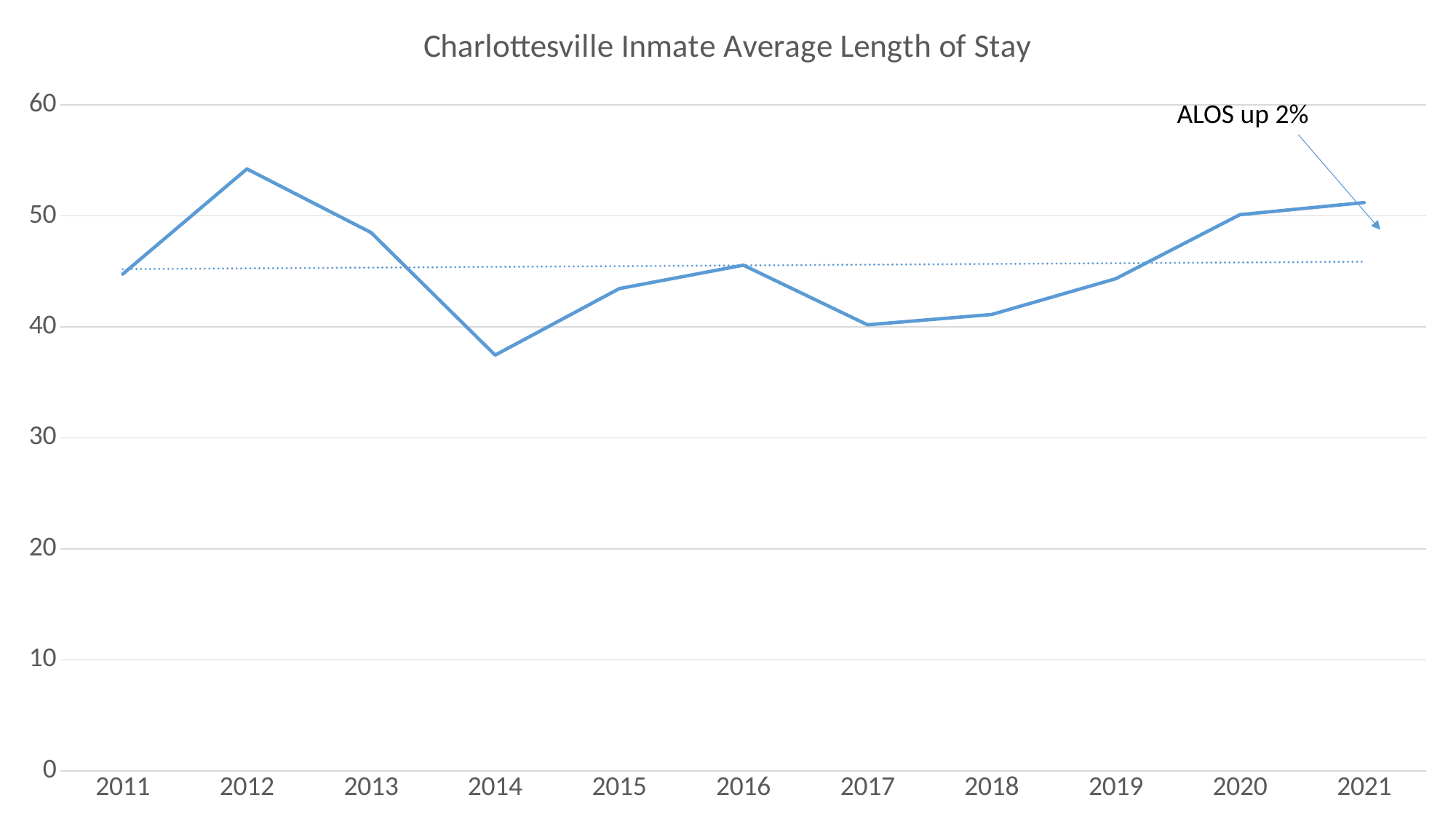
Which year has the lowest average length of stay? 2014 Is the value for 2021 greater or less than 50? greater How many years are plotted along the x axis? 11 What does the annotation near the 2021 point say? ALOS up 2% Which year has a higher value, 2013 or 2015? 2013 Is the value for 2017 greater or less than 50? less What kind of chart is shown on the slide? line chart Which year has the highest average length of stay? 2012 Is the value for 2012 greater or less than 50? greater What is the title of the chart? Charlottesville Inmate Average Length of Stay Do the values rise or fall from 2017 to 2021? rise